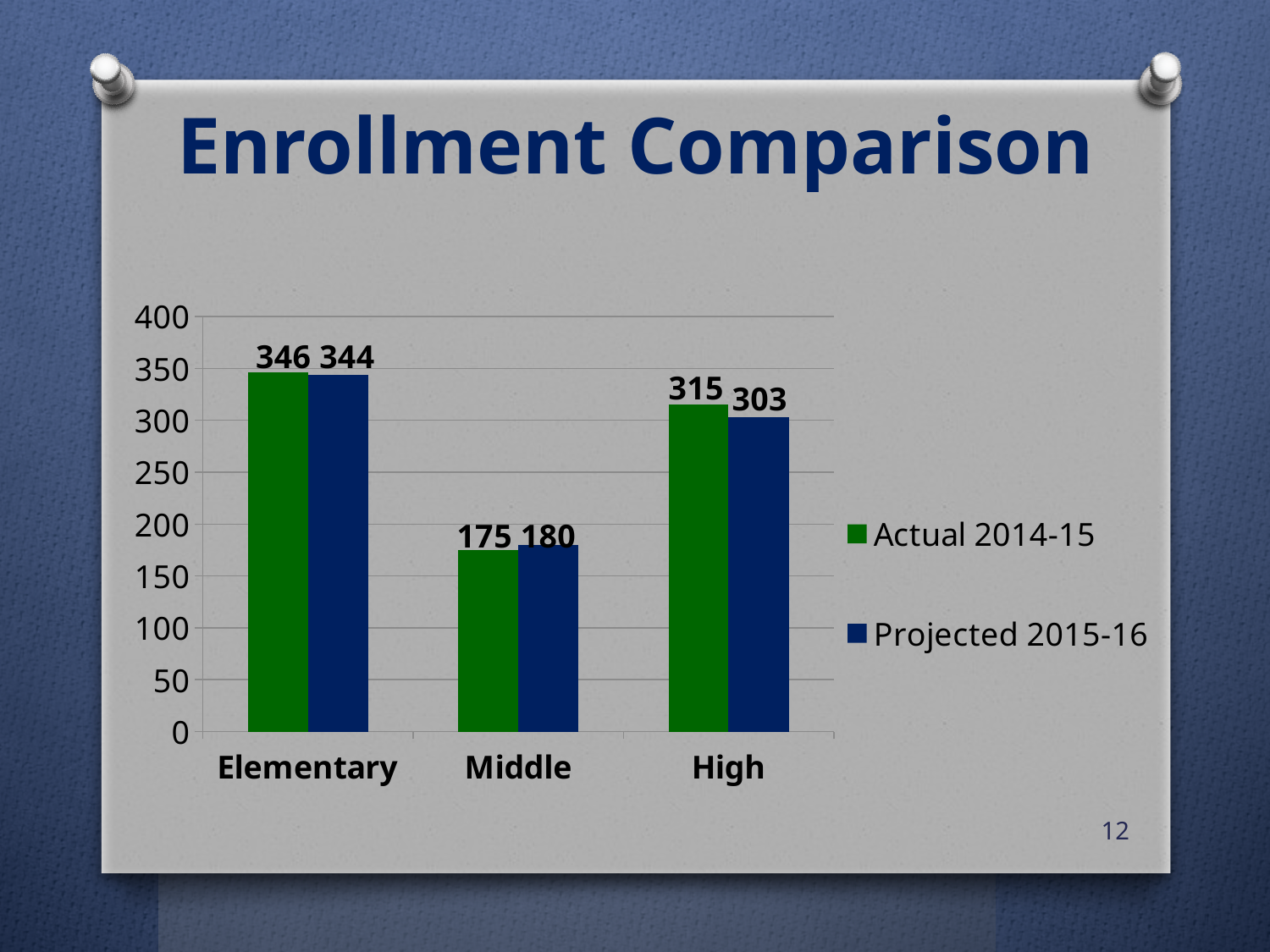
Which school level has the lowest Projected 2015-16 enrollment? Middle What is the difference between the Actual 2014-15 and Projected 2015-16 enrollment for High? 12 How many school levels are shown on the x axis? 3 Which is larger for Middle: the Actual 2014-15 or the Projected 2015-16 enrollment? Projected 2015-16 What is the Projected 2015-16 enrollment for Middle? 180 How many series does the legend list? 2 What kind of chart is shown on the slide? Bar chart What is the difference between the Projected 2015-16 enrollment for Elementary and for Middle? 164 Which school level has the highest Actual 2014-15 enrollment? Elementary What is the Projected 2015-16 enrollment for High? 303 What is the Actual 2014-15 enrollment for Elementary? 346 What is the title of the slide? Enrollment Comparison